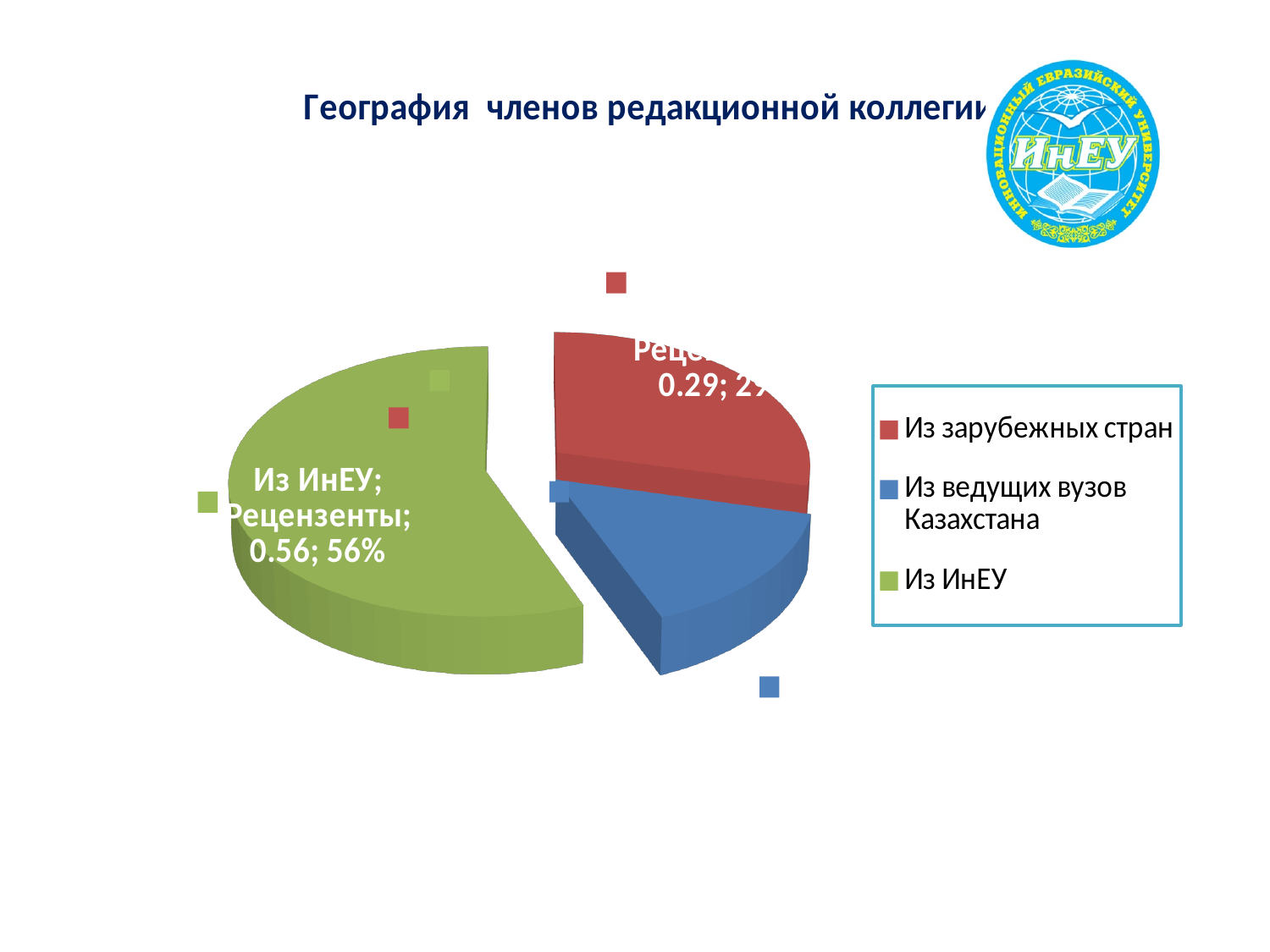
What value is printed on the data label of the 'Из ИнЕУ' slice before the percentage? 0.56 Which category has the largest slice of the pie? Из ИнЕУ Which slice is larger: 'Из ИнЕУ' or 'Из зарубежных стран'? Из ИнЕУ What is the title of the chart? География членов редакционной коллегии What kind of chart is shown on the slide? pie chart What percentage share of the pie does the 'Из ИнЕУ' slice have? 56% Which slice is larger: 'Из зарубежных стран' or 'Из ведущих вузов Казахстана'? Из зарубежных стран How many categories does the legend of the pie chart list? 3 What value is printed on the data label of the red 'Из зарубежных стран' slice? 0.29 Is the share of the 'Из ИнЕУ' slice greater or less than 50%? greater Which category has the smallest slice of the pie? Из ведущих вузов Казахстана What colour is the 'Из ИнЕУ' slice in the pie chart? green